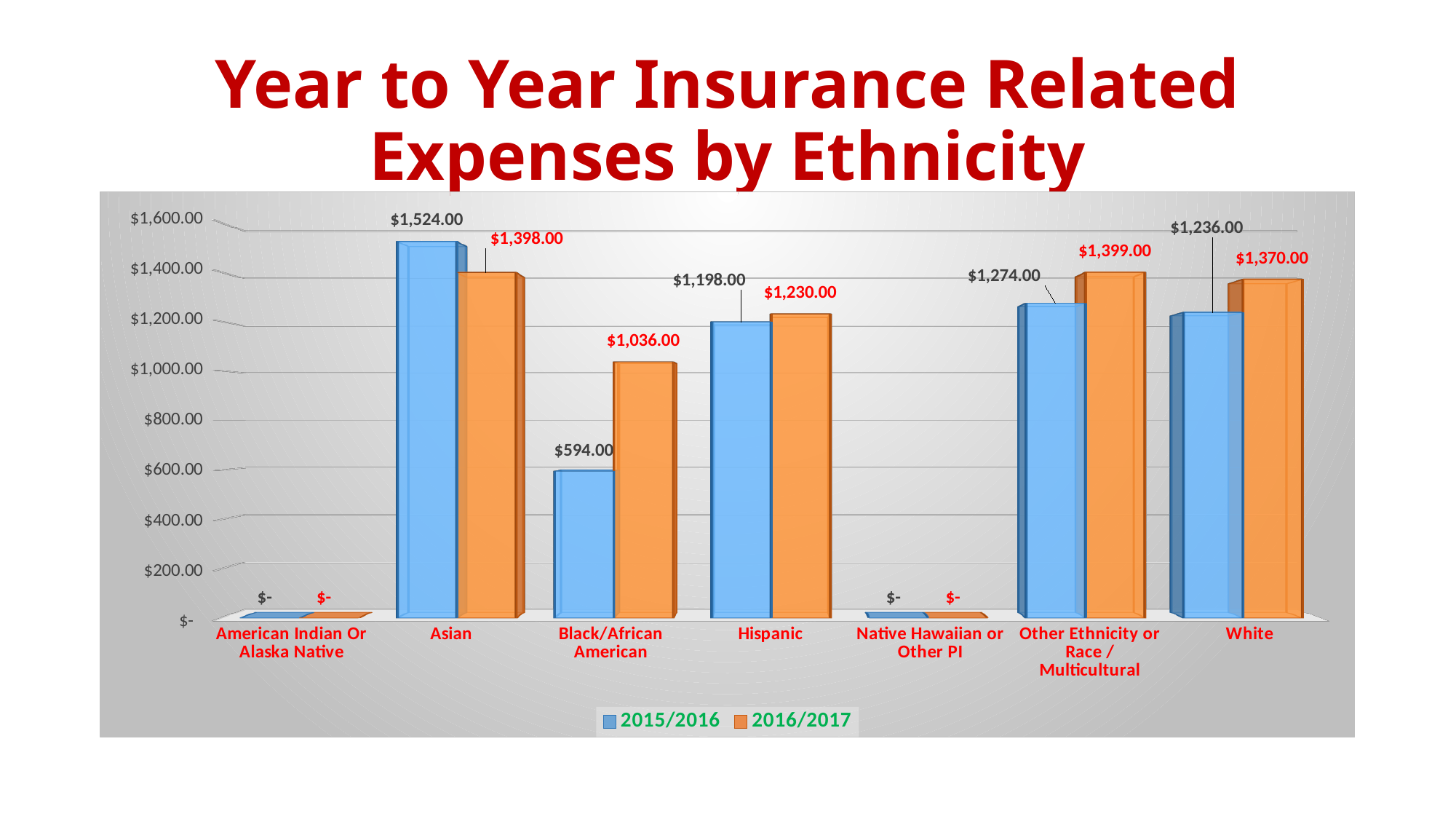
How many ethnicity categories are shown on the x axis? 7 What is the title of the chart? Year to Year Insurance Related Expenses by Ethnicity Among categories with non-zero values, which has the lowest 2015/2016 value? Black/African American What is the 2016/2017 value for White? $1,370.00 What is the 2015/2016 value for Asian? $1,524.00 Which category has the highest 2015/2016 value? Asian What is the 2016/2017 value for Black/African American? $1,036.00 How many series does the legend list? 2 Is the 2016/2017 value for Other Ethnicity or Race / Multicultural greater or less than $1,200.00? greater What kind of chart is shown on the slide? bar chart What is the difference between the 2015/2016 and 2016/2017 values for Black/African American? $442.00 Which is larger for Hispanic: the 2015/2016 value or the 2016/2017 value? 2016/2017